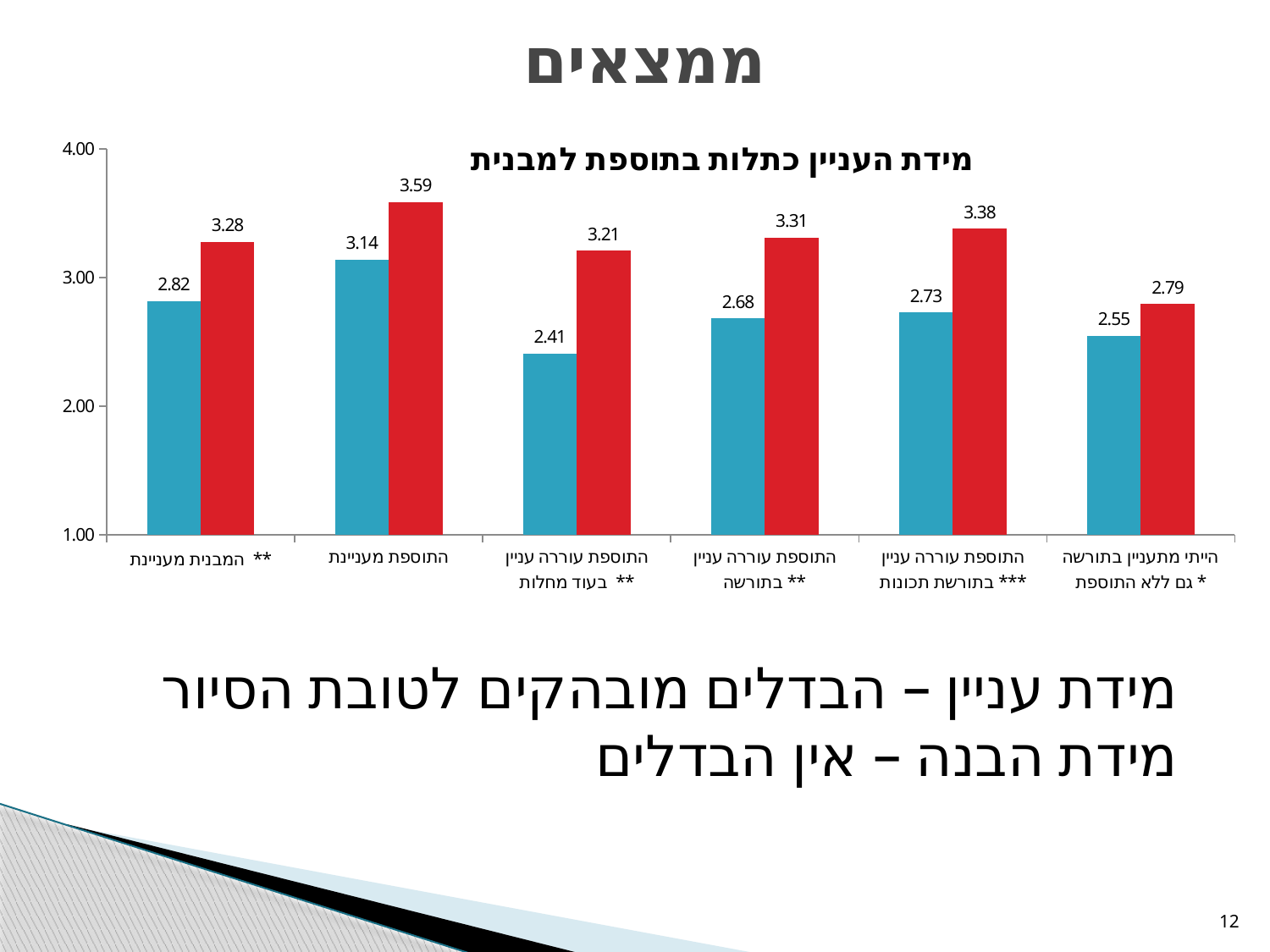
What is the value of the red bar for the category 'התוספת מעניינת'? 3.59 What type of chart is shown on the slide? bar chart Which category has the highest red bar? התוספת מעניינת What colours are the two series of bars in the chart? blue and red What is the value of the blue bar for the category 'התוספת עוררה עניין בעוד מחלות'? 2.41 Is the value of the red bar for 'הייתי מתעניין בתורשה גם ללא התוספת' greater or less than 3.00? less What is the value of the blue bar for the category 'הייתי מתעניין בתורשה גם ללא התוספת'? 2.55 Which is larger for the category 'המבנית מעניינת': the blue bar or the red bar? the red bar How many categories are shown on the x axis of the chart? 6 Which category has the lowest blue bar? התוספת עוררה עניין בעוד מחלות What is the title of the chart? מידת העניין כתלות בתוספת למבנית What is the difference between the red and blue bars for the category 'התוספת עוררה עניין בעוד מחלות'? 0.80